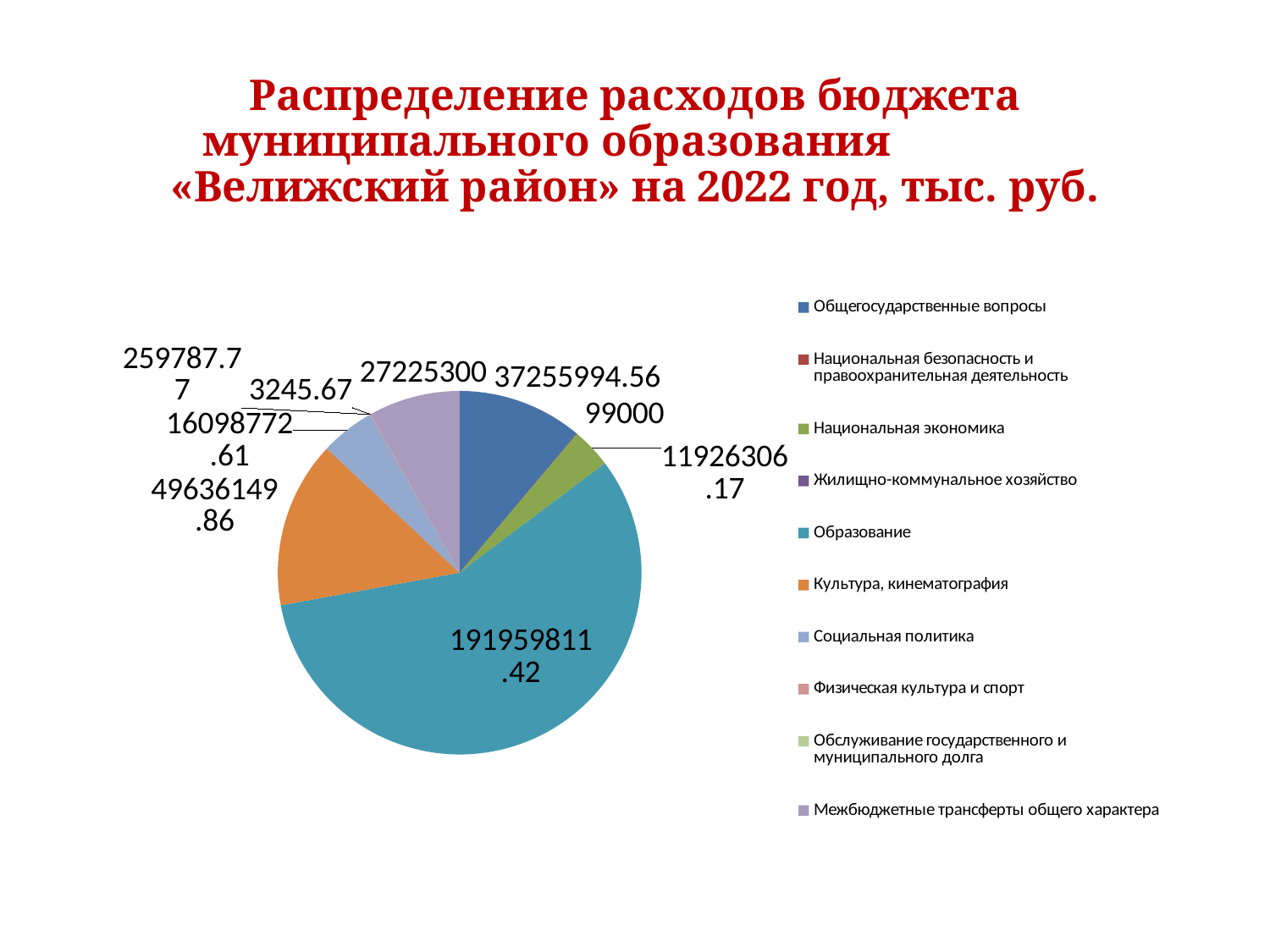
What is the value for Социальная политика? 16098772.61 What kind of chart is shown on the slide? pie chart What is the difference between Культура, кинематография and Социальная политика? 33537377.25 What is the value for Национальная экономика? 11926306.17 What is the value for Общегосударственные вопросы? 37255994.56 What is the value for Образование? 191959811.42 Which category has the largest slice of the pie? Образование What is the value for Культура, кинематография? 49636149.86 What is the value for Межбюджетные трансферты общего характера? 27225300 Which is larger, Общегосударственные вопросы or Межбюджетные трансферты общего характера? Общегосударственные вопросы What year does the chart title say the budget expenditure distribution is for? 2022 How many entries does the legend list? 10